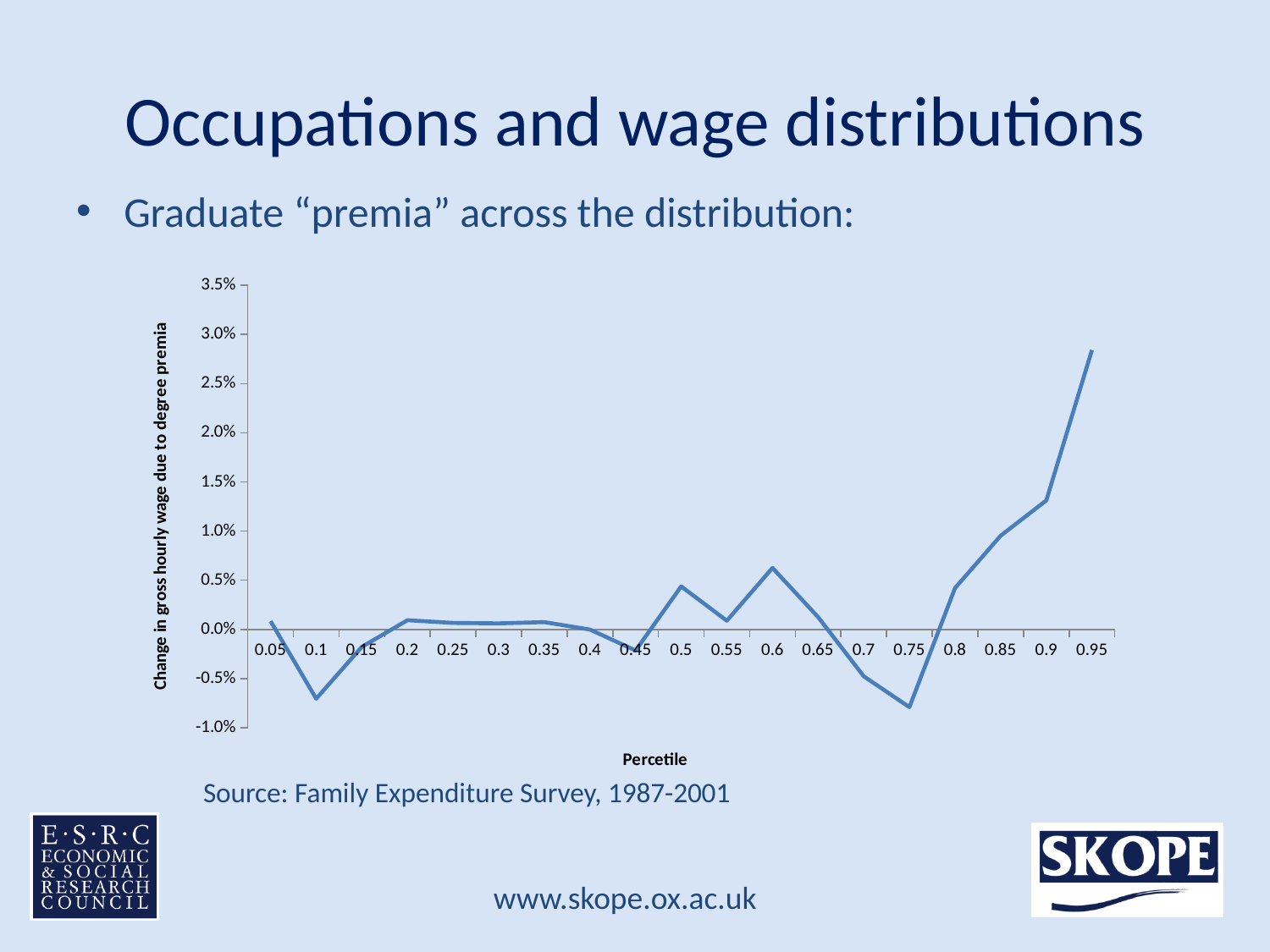
Is the value at the 0.75 percentile greater or less than -0.5%? less What is the title of the y axis? Change in gross hourly wage due to degree premia Is the value at the 0.9 percentile greater or less than 1.0%? greater Does the line rise or fall between the 0.75 and 0.95 percentiles? rise What is the title of the x axis? Percetile Is the value at the 0.7 percentile greater or less than 0.0%? less What kind of chart is shown on the slide? line chart Which has the larger value, the 0.5 percentile or the 0.55 percentile? 0.5 At which percentile is the change in gross hourly wage due to degree premia highest? 0.95 Which has the larger value, the 0.6 percentile or the 0.65 percentile? 0.6 How many percentile points are plotted along the x axis? 19